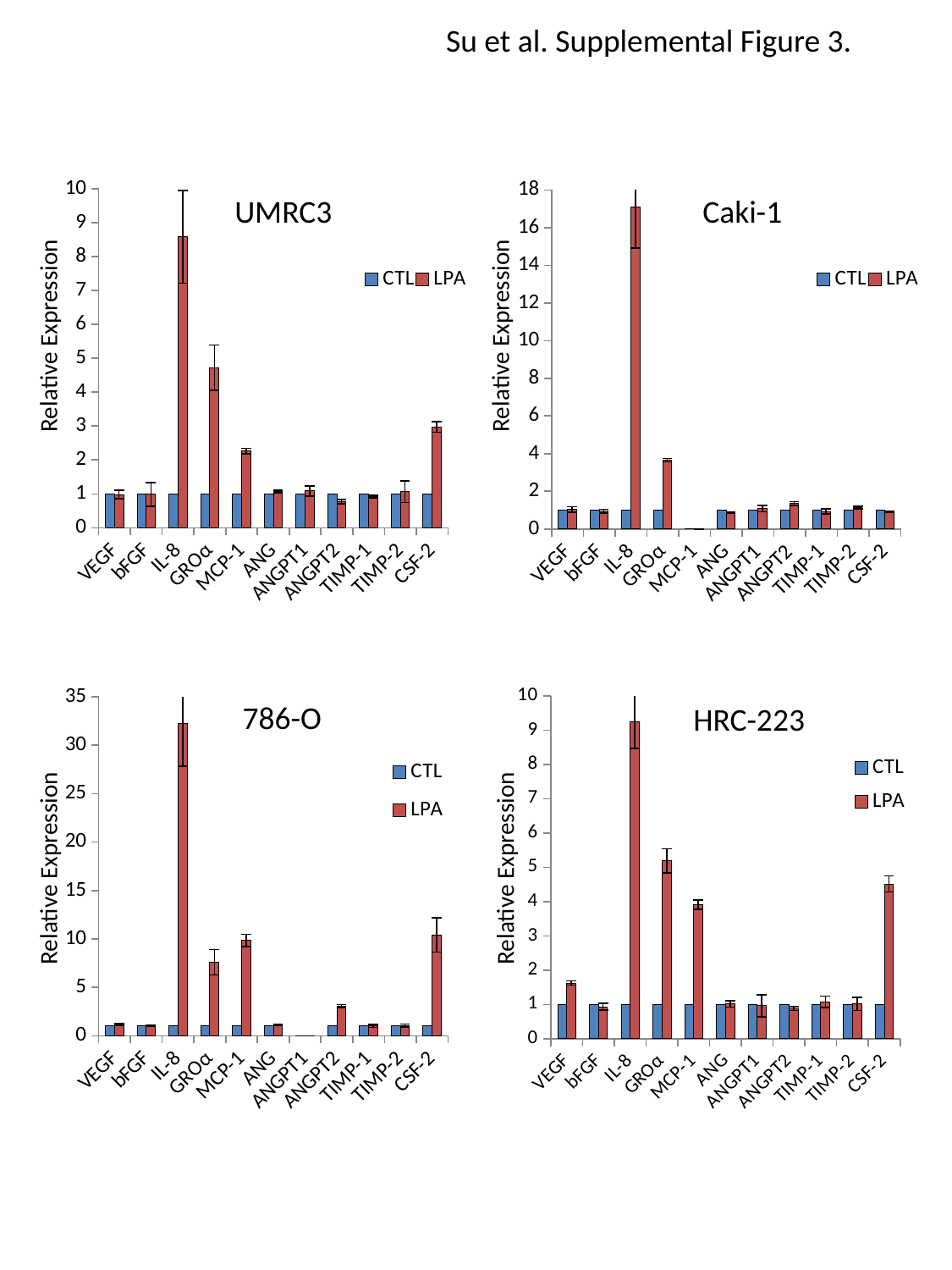
How many series does the legend of the Caki-1 chart list? 2 In the HRC-223 chart, is the LPA value for CSF-2 greater or less than 4? greater In the Caki-1 chart, is the LPA value for IL-8 greater or less than 14? greater In the Caki-1 chart, which category has the highest LPA value? IL-8 How many categories are shown on the x axis of the UMRC3 chart? 11 In the 786-O chart, is the LPA value for IL-8 greater or less than 30? greater In the HRC-223 chart, which category has the highest LPA value? IL-8 In the UMRC3 chart, which category has the highest LPA value? IL-8 In the 786-O chart, which has the larger LPA value, MCP-1 or GROα? MCP-1 What are the two legend entries in the 786-O chart? CTL and LPA What kind of chart is the UMRC3 chart? bar chart